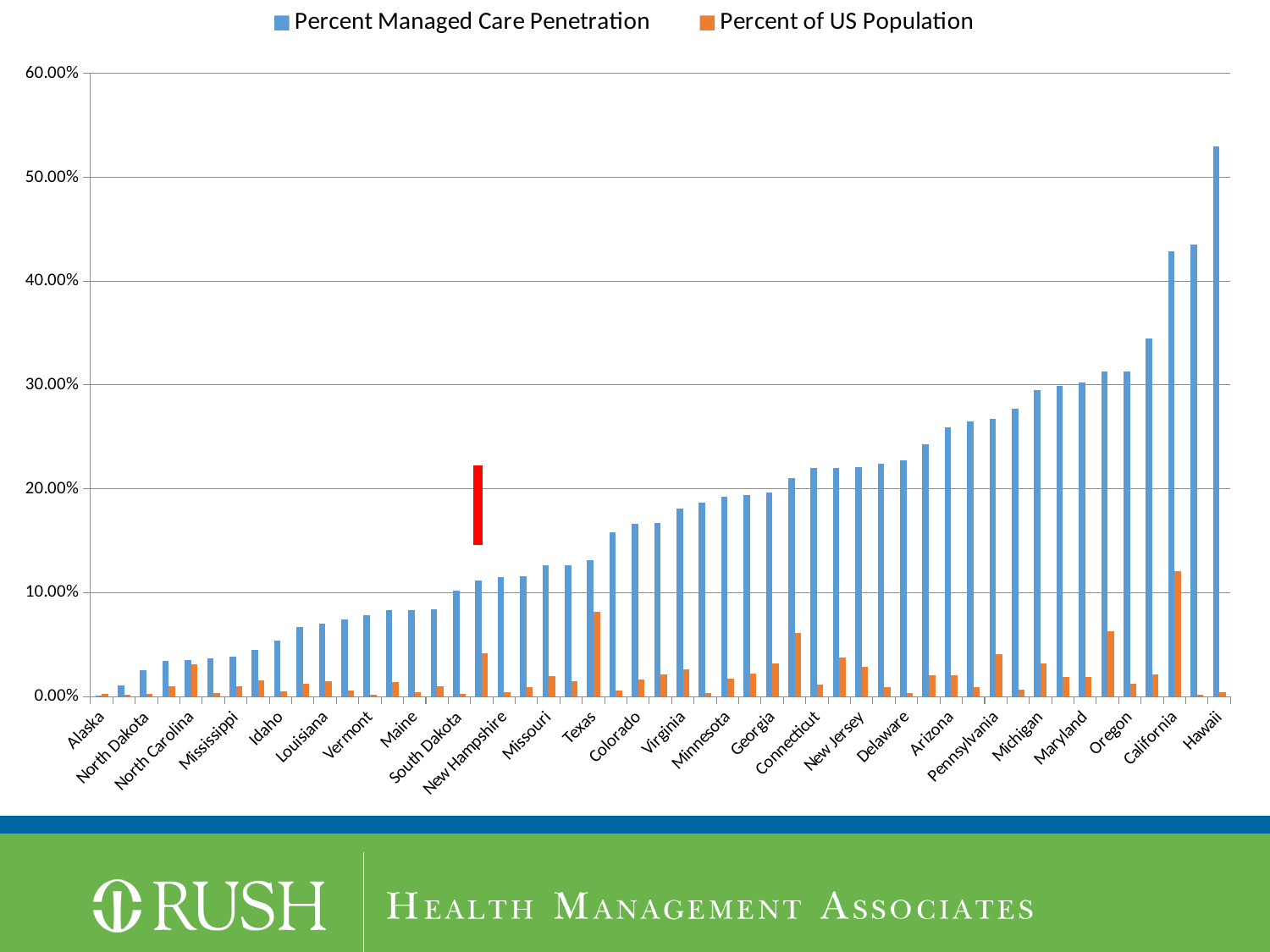
Is the Percent Managed Care Penetration for Pennsylvania greater or less than 30.00%? less Which state has the highest Percent of US Population? California How many series does the legend list? 2 Is the Percent Managed Care Penetration for California greater or less than 40.00%? greater Which has the larger Percent of US Population, Texas or Colorado? Texas What kind of chart is shown on the slide? bar chart Is the Percent of US Population for California greater or less than 10.00%? greater Do the Percent Managed Care Penetration values rise or fall from left to right along the x axis? rise What are the two series named in the legend? Percent Managed Care Penetration; Percent of US Population Which state has the highest Percent Managed Care Penetration? Hawaii Which colour represents Percent of US Population? orange